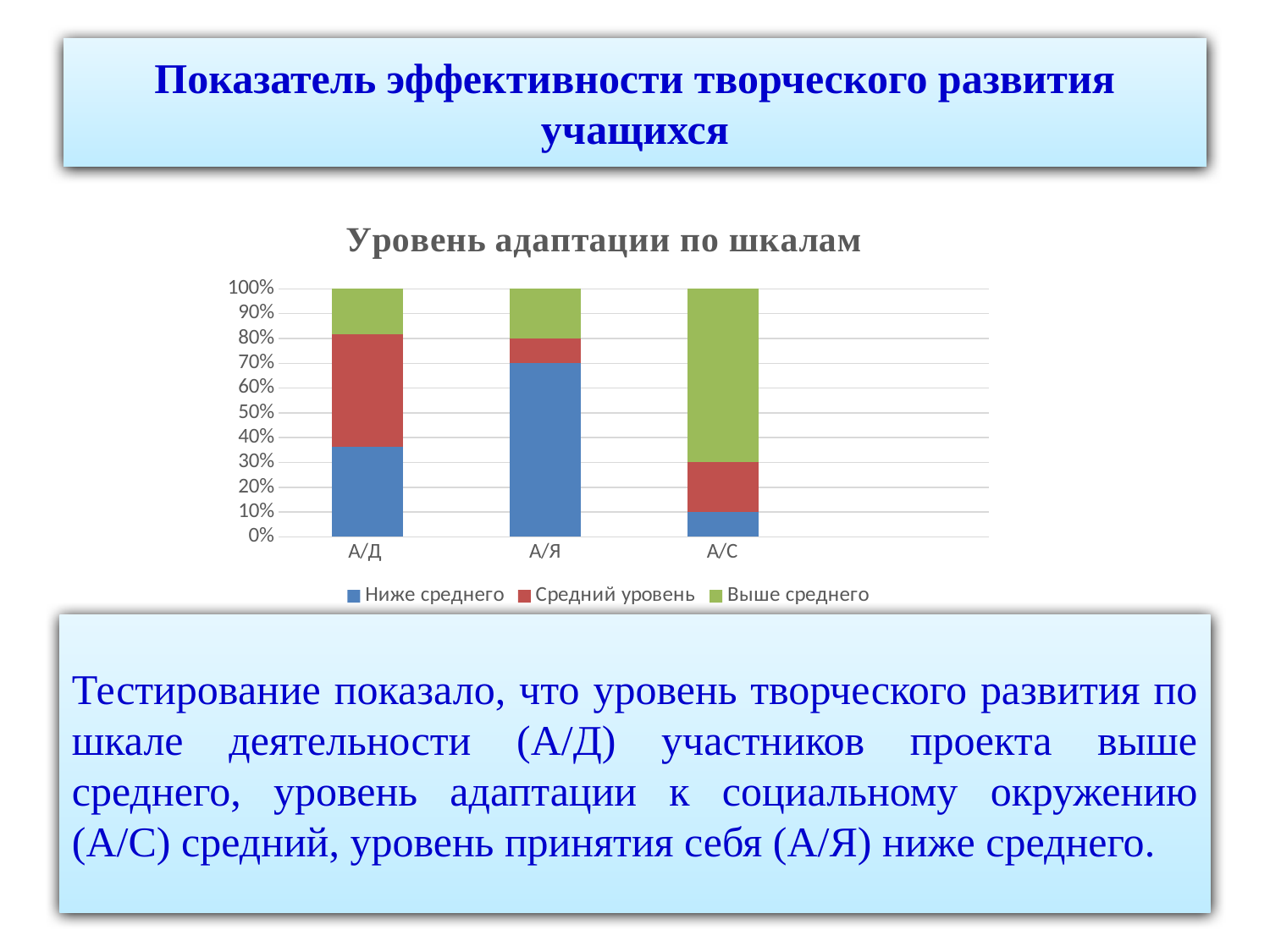
What is the title of the chart? Уровень адаптации по шкалам What kind of chart is shown on the slide? stacked bar chart How many categories are shown on the x axis of the chart? 3 Which category has a larger Средний уровень share, А/Д or А/Я? А/Д Is the value of Ниже среднего for А/Д greater or less than 50%? less Is the value of Ниже среднего for А/С greater or less than 20%? less Which category has the largest Выше среднего share? А/С Is the value of Ниже среднего for А/Я greater or less than 60%? greater Which category has the largest Ниже среднего share? А/Я Which category has the smallest Ниже среднего share? А/С How many series does the chart legend list? 3 Which series is shown in green in the chart? Выше среднего